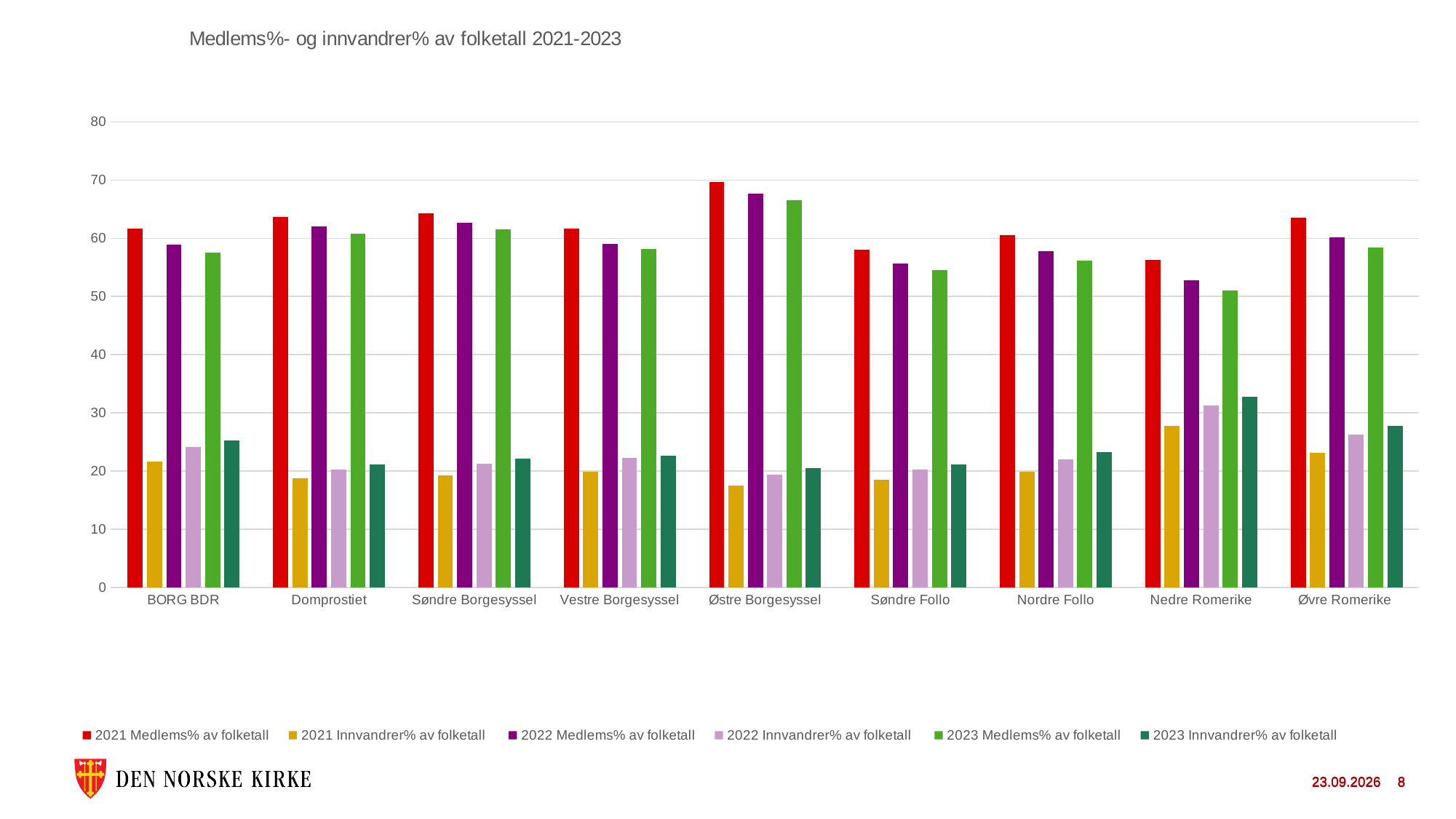
Is the value for 2021 Medlems% av folketall in Østre Borgesyssel greater or less than 60? greater Which category has the highest value for 2023 Innvandrer% av folketall? Nedre Romerike Is the value for 2023 Innvandrer% av folketall in Nedre Romerike greater or less than 30? greater How many series does the legend list? 6 Which category has the lowest value for 2023 Medlems% av folketall? Nedre Romerike What is the title of the chart? Medlems%- og innvandrer% av folketall 2021-2023 Within Nedre Romerike, do the Medlems% av folketall values rise or fall from 2021 to 2023? fall Is the value for 2021 Innvandrer% av folketall in Domprostiet greater or less than 20? less How many categories are shown on the x axis? 9 Which category has the highest value for 2021 Medlems% av folketall? Østre Borgesyssel Which is larger: 2022 Innvandrer% av folketall in Nedre Romerike or in BORG BDR? Nedre Romerike What kind of chart is shown on the slide? bar chart